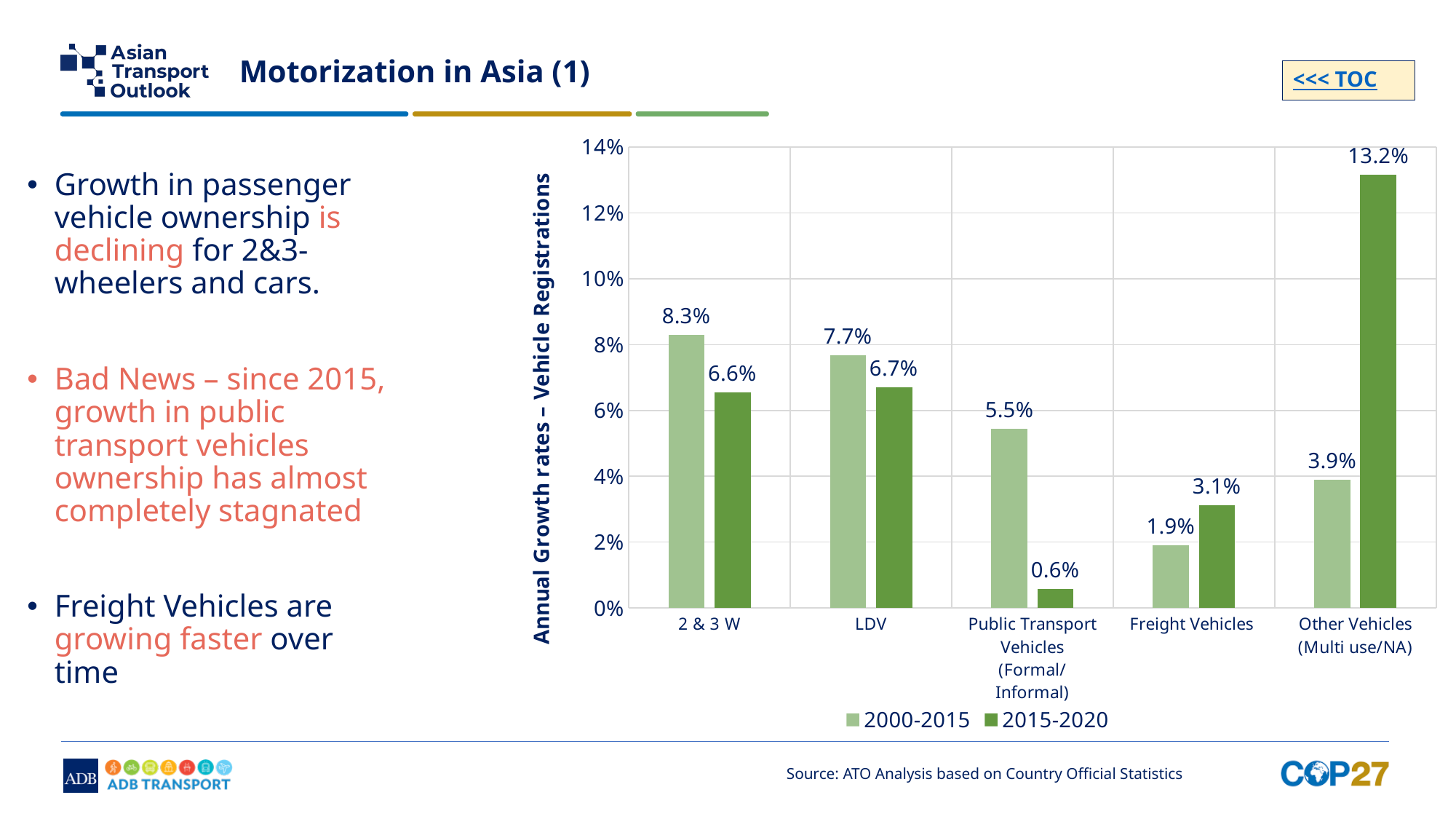
What is the 2015-2020 annual growth rate for Public Transport Vehicles (Formal/Informal)? 0.6% What is the 2000-2015 annual growth rate for 2 & 3 W? 8.3% Which category has the highest 2015-2020 annual growth rate? Other Vehicles (Multi use/NA) What is the difference between the 2000-2015 and 2015-2020 growth rates for Public Transport Vehicles (Formal/Informal)? 4.9% What is the label of the vertical axis? Annual Growth rates – Vehicle Registrations For LDV, which period has the higher annual growth rate, 2000-2015 or 2015-2020? 2000-2015 How many vehicle categories are shown on the x axis? 5 What kind of chart is shown on the slide? Bar chart Which category has the lowest 2000-2015 annual growth rate? Freight Vehicles What is the 2000-2015 annual growth rate for Freight Vehicles? 1.9% How many series does the legend list? 2 What is the 2015-2020 annual growth rate for Other Vehicles (Multi use/NA)? 13.2%